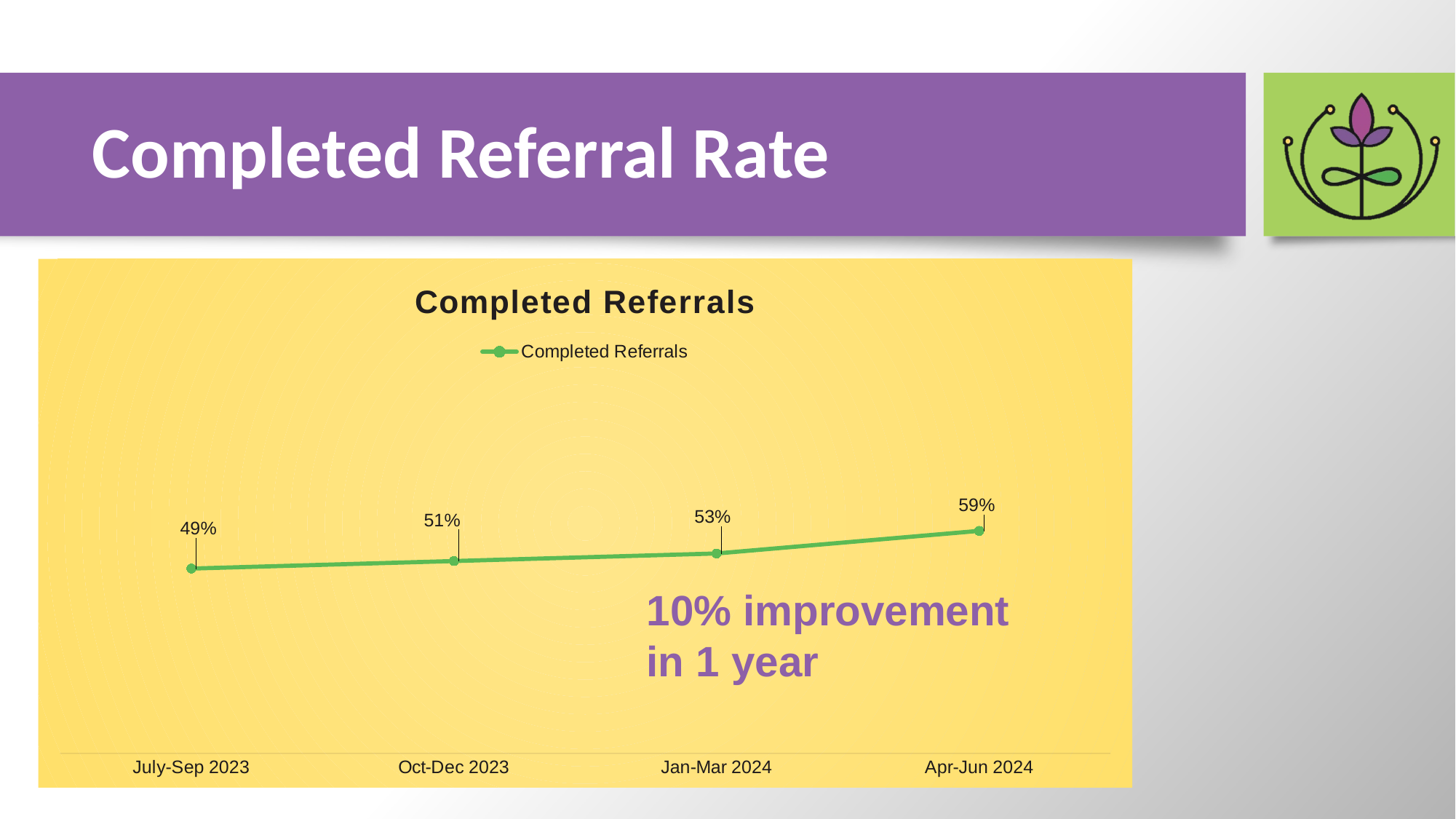
Which is larger, the completed referral rate for Jan-Mar 2024 or Oct-Dec 2023? Jan-Mar 2024 How many quarters are plotted on the chart? 4 What is the completed referral rate for Oct-Dec 2023? 51% What is the difference between the completed referral rate in Apr-Jun 2024 and July-Sep 2023? 10% How many series does the legend list? 1 What kind of chart is shown on the slide? Line chart What is the completed referral rate for Apr-Jun 2024? 59% Which quarter has the lowest completed referral rate? July-Sep 2023 What is the completed referral rate for Jan-Mar 2024? 53% Which quarter has the highest completed referral rate? Apr-Jun 2024 What is the completed referral rate for July-Sep 2023? 49% Do the completed referral rates rise or fall from July-Sep 2023 to Apr-Jun 2024? Rise